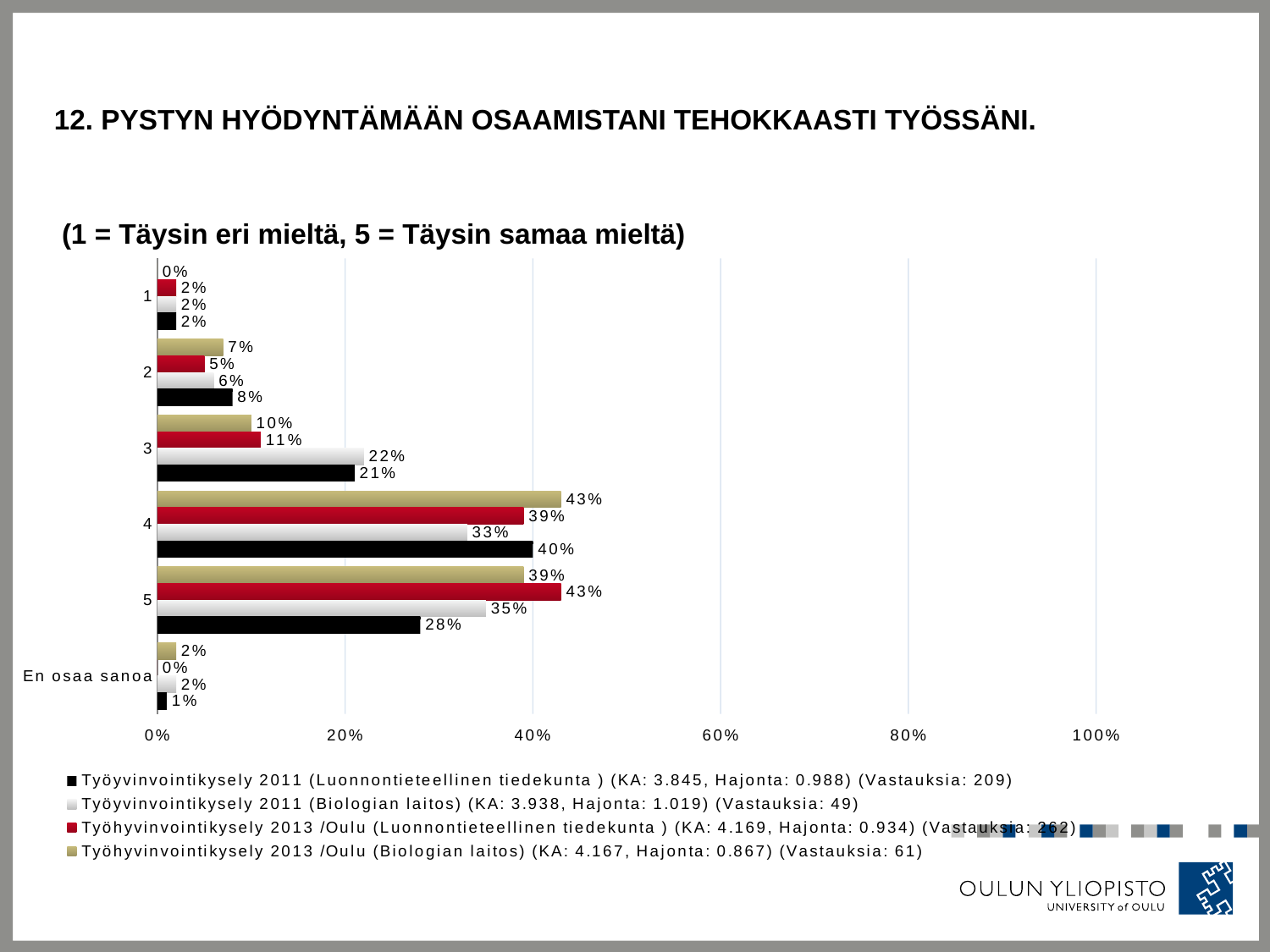
What is the value for En osaa sanoa in the Työhyvinvointikysely 2013 /Oulu (Luonnontieteellinen tiedekunta) series? 0% What kind of chart is shown on the slide? bar chart How many series does the legend list? 4 What is the value for category 4 in the Työhyvinvointikysely 2013 /Oulu (Biologian laitos) series? 43% Which category has the highest value in the Työhyvinvointikysely 2013 /Oulu (Luonnontieteellinen tiedekunta) series? 5 What is the value for category 5 in the Työyvinvointikysely 2011 (Luonnontieteellinen tiedekunta) series? 28% What is the difference between the Työhyvinvointikysely 2013 /Oulu (Biologian laitos) value and the Työyvinvointikysely 2011 (Biologian laitos) value for category 4? 10% For category 5, which is larger: the Työhyvinvointikysely 2013 /Oulu (Luonnontieteellinen tiedekunta) value or the Työyvinvointikysely 2011 (Biologian laitos) value? Työhyvinvointikysely 2013 /Oulu (Luonnontieteellinen tiedekunta) What is the value for category 2 in the Työhyvinvointikysely 2013 /Oulu (Luonnontieteellinen tiedekunta) series? 5% How many categories are shown on the vertical axis? 6 What is the value for category 3 in the Työyvinvointikysely 2011 (Biologian laitos) series? 22% Which category has the highest value in the Työyvinvointikysely 2011 (Luonnontieteellinen tiedekunta) series? 4